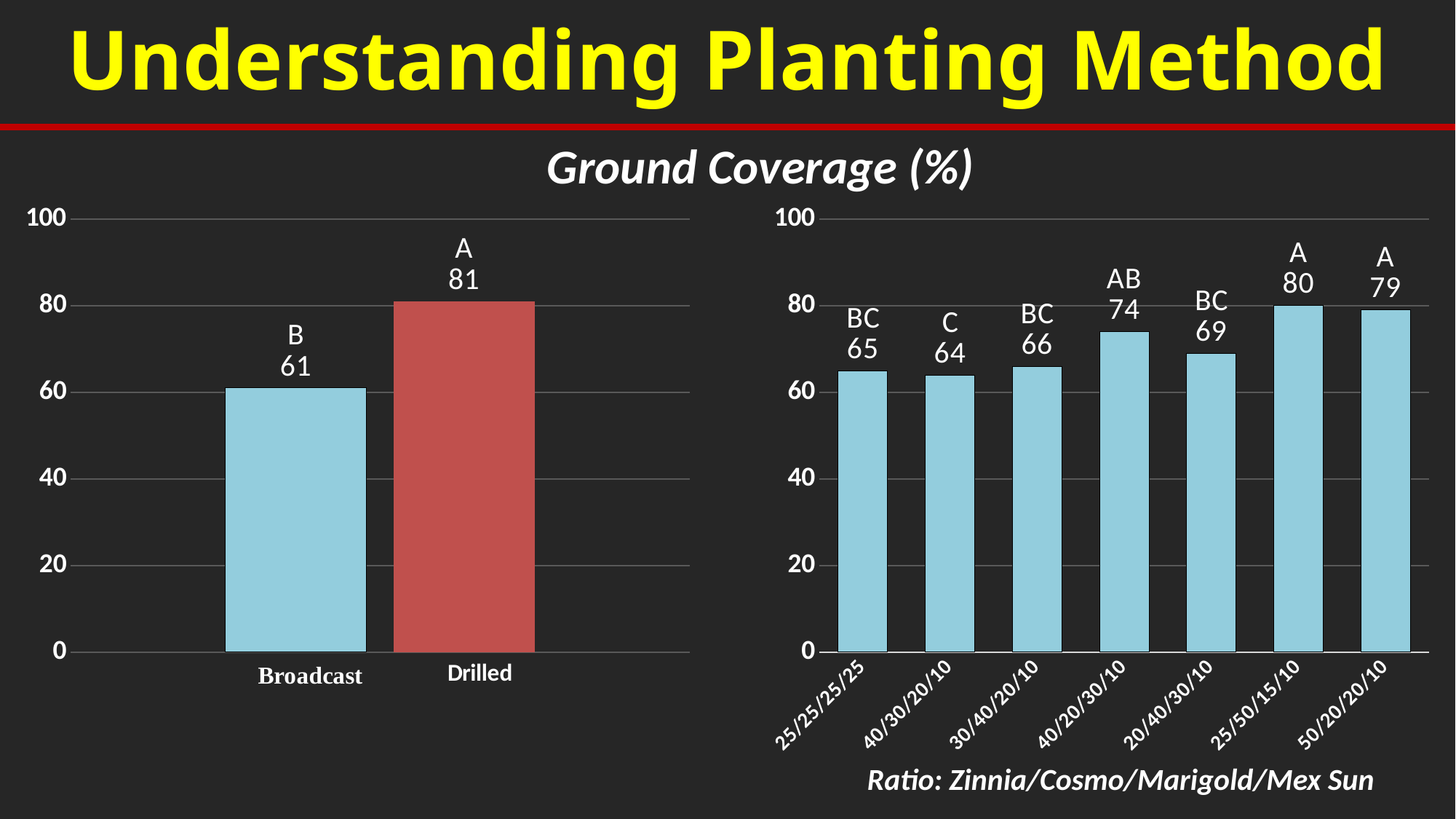
In the left chart, what is the difference between the Drilled and Broadcast values? 20 What kind of chart is the left chart? Bar chart In the right chart, what is the difference between the values for 25/50/15/10 and 25/25/25/25? 15 In the left chart, what is the ground coverage value for Drilled? 81 In the right chart, what is the value for the 40/20/30/10 ratio? 74 In the left chart, which planting method has the higher ground coverage? Drilled In the right chart, how many ratio categories are plotted? 7 In the left chart, how many bars are plotted? 2 In the right chart, what is the value for the 20/40/30/10 ratio? 69 In the right chart, which ratio has the highest ground coverage? 25/50/15/10 In the left chart, what is the ground coverage value for Broadcast? 61 In the right chart, which ratio has the lowest ground coverage? 40/30/20/10